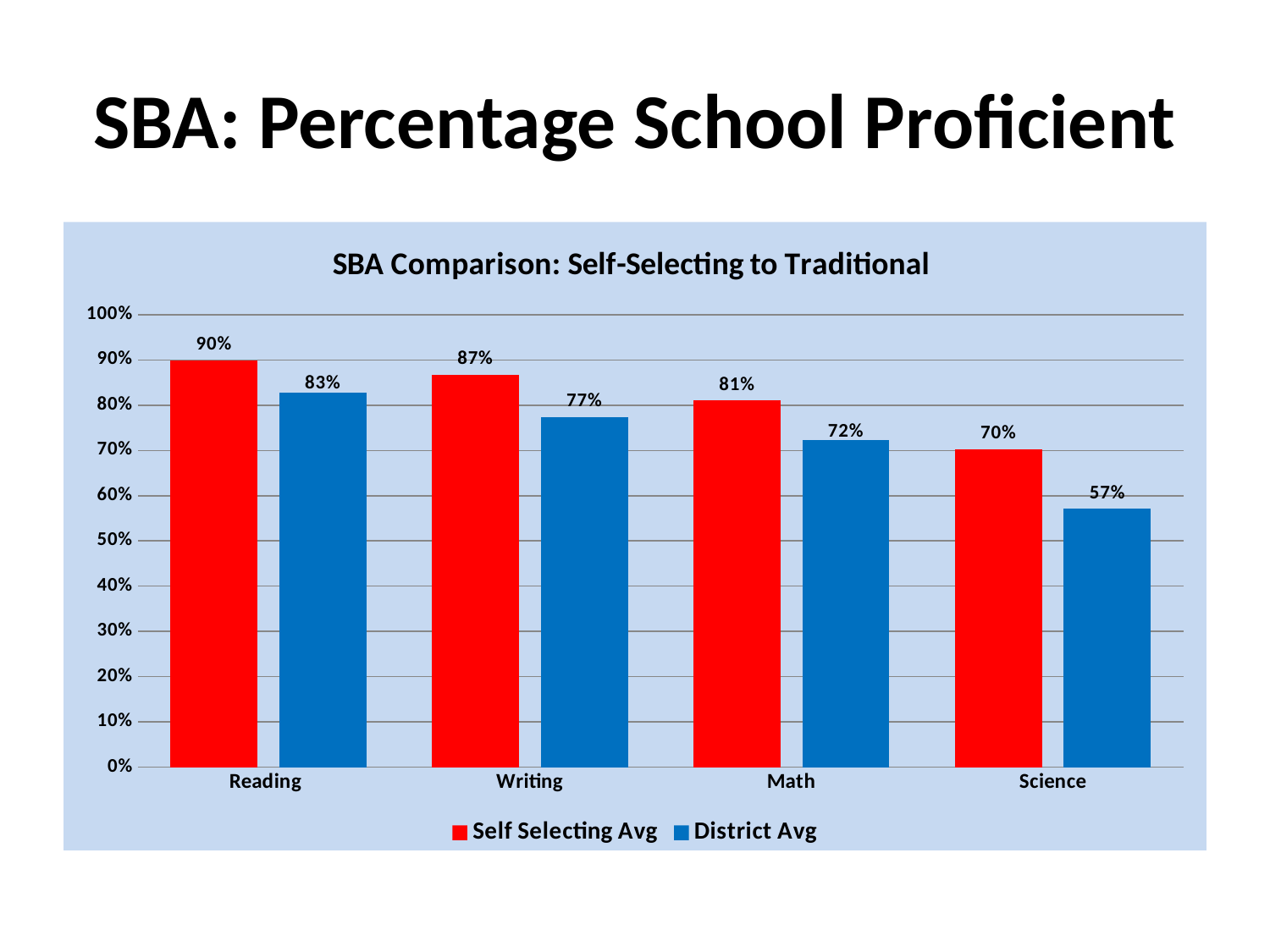
What kind of chart is shown? Bar chart How many series does the legend list? 2 What is the difference between the Self Selecting Avg and the District Avg for Math? 9% What is the difference between the Self Selecting Avg and the District Avg for Science? 13% Which is larger: the District Avg for Reading or the Self Selecting Avg for Math? District Avg for Reading How many subjects are shown on the x axis? 4 What is the District Avg value for Writing? 77% Which subject has the lowest District Avg? Science What is the Self Selecting Avg value for Reading? 90% What is the title of the chart? SBA Comparison: Self-Selecting to Traditional What is the District Avg value for Science? 57% Which subject has the highest Self Selecting Avg? Reading